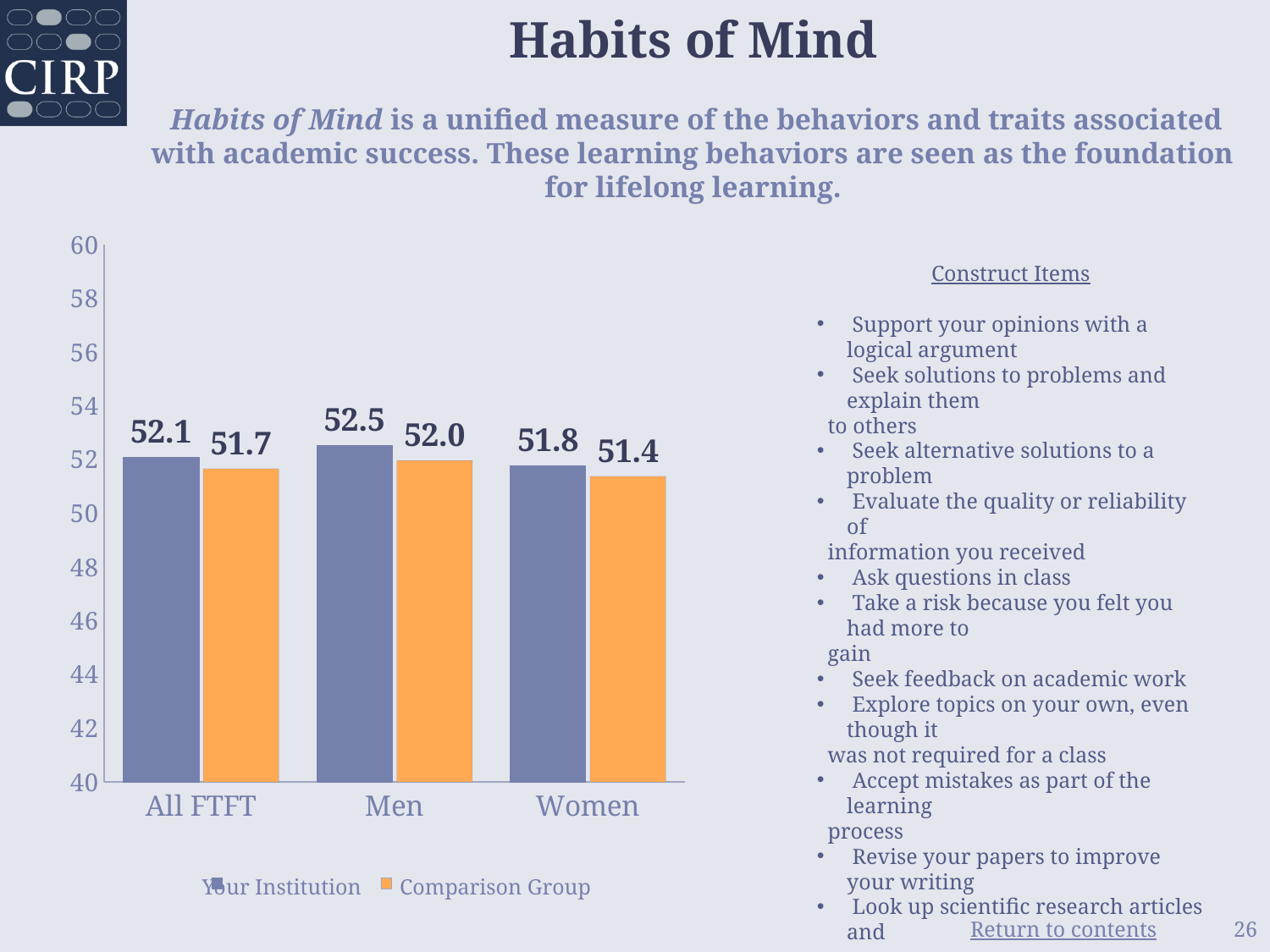
What is the Your Institution value for All FTFT? 52.1 What is the title of the slide containing the chart? Habits of Mind How many series does the legend list? 2 What is the Comparison Group value for Men? 52.0 What is the Your Institution value for Women? 51.8 How many categories are shown on the x axis? 3 For All FTFT, which is larger: Your Institution or Comparison Group? Your Institution Which category has the highest Your Institution value? Men What is the difference between the Your Institution and Comparison Group values for Men? 0.5 Which category has the lowest Comparison Group value? Women What is the Comparison Group value for Women? 51.4 What kind of chart is shown on the slide? Bar chart